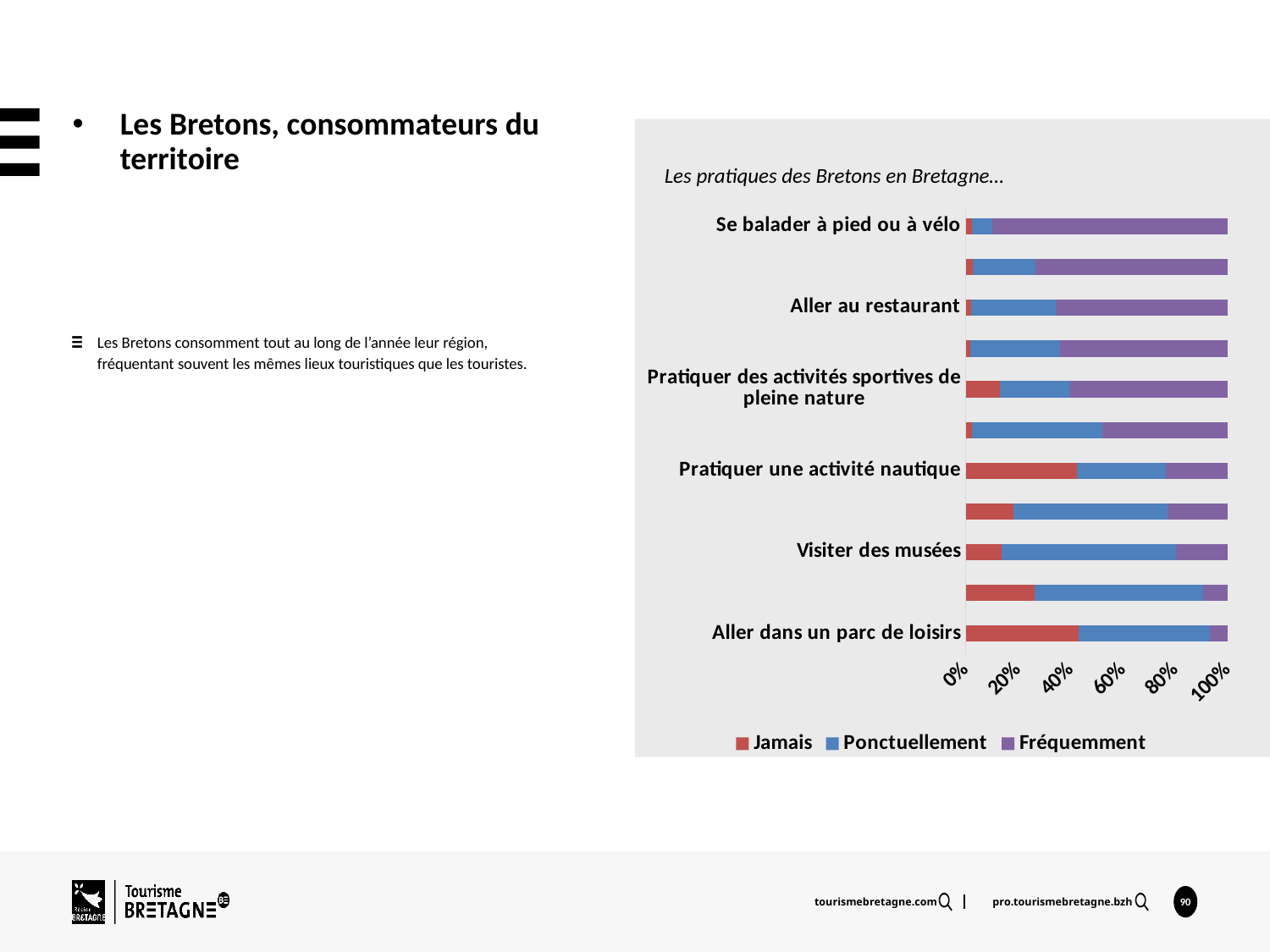
Is the 'Fréquemment' value for 'Se balader à pied ou à vélo' greater or less than 80%? greater Is the 'Fréquemment' value for 'Aller dans un parc de loisirs' greater or less than 20%? less Among the labelled activities, which has the smallest 'Fréquemment' share? Aller dans un parc de loisirs How many series does the chart legend list? 3 Which has the larger 'Jamais' share: 'Se balader à pied ou à vélo' or 'Aller dans un parc de loisirs'? Aller dans un parc de loisirs What are the three series named in the chart legend? Jamais, Ponctuellement, Fréquemment Is the 'Jamais' value for 'Aller dans un parc de loisirs' greater or less than 20%? greater What kind of chart is shown on the slide? Stacked bar chart Among the labelled activities, which has the largest 'Fréquemment' share? Se balader à pied ou à vélo What is the title of the chart? Les pratiques des Bretons en Bretagne…